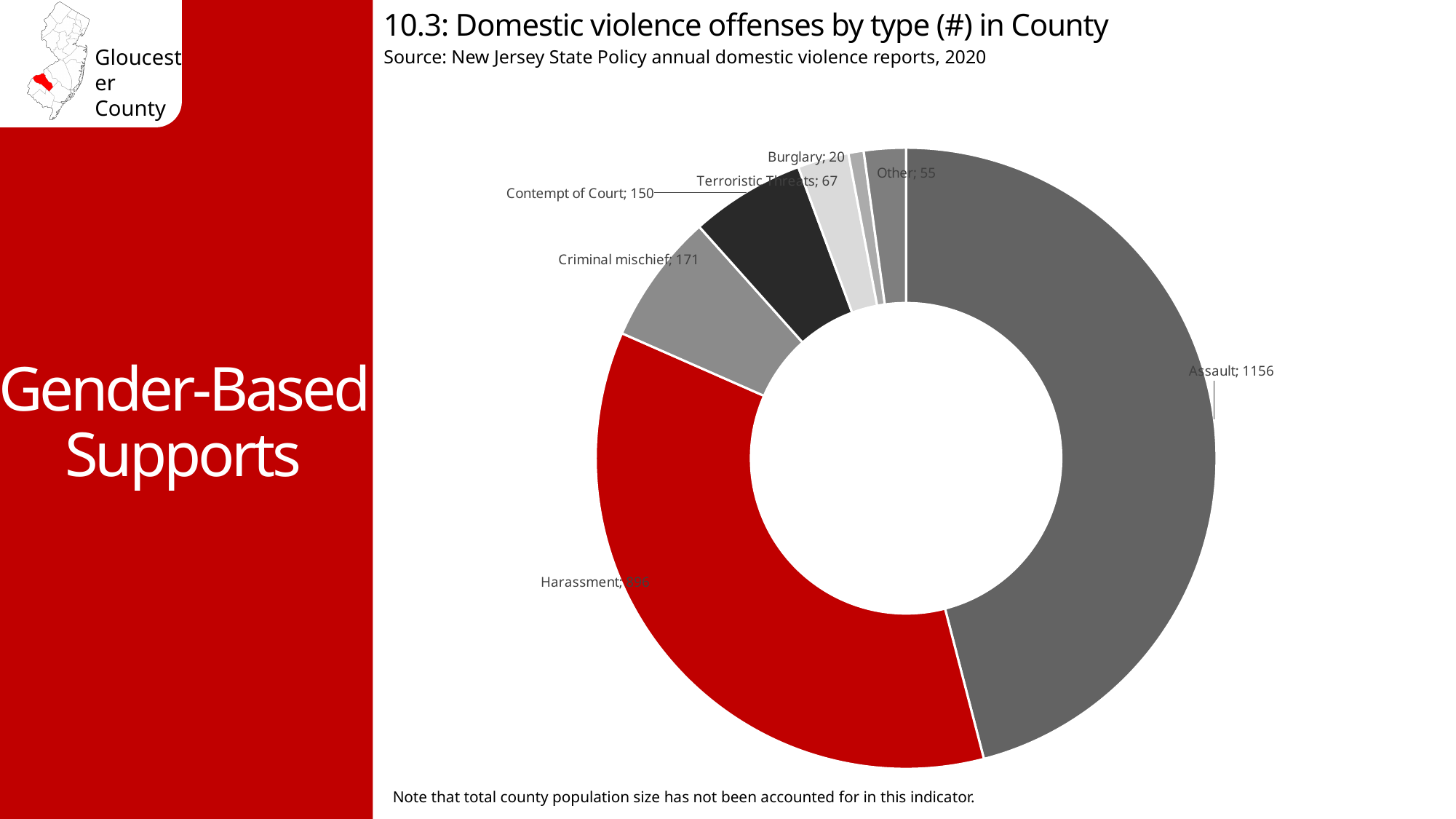
What is the value for the Other category? 55 How many domestic violence offenses of type Assault are shown? 1156 What is the difference between Criminal mischief and Contempt of Court? 21 Which offense type has the highest number of offenses? Assault How many offense types are shown in the chart? 7 Which offense type has the lowest number of offenses? Burglary What kind of chart is shown on the slide? doughnut chart What is the value for Terroristic Threats? 67 What is the value for Criminal mischief? 171 What is the value for Burglary? 20 What is the value for Contempt of Court? 150 Which is larger, the Assault slice or the Harassment slice? Assault